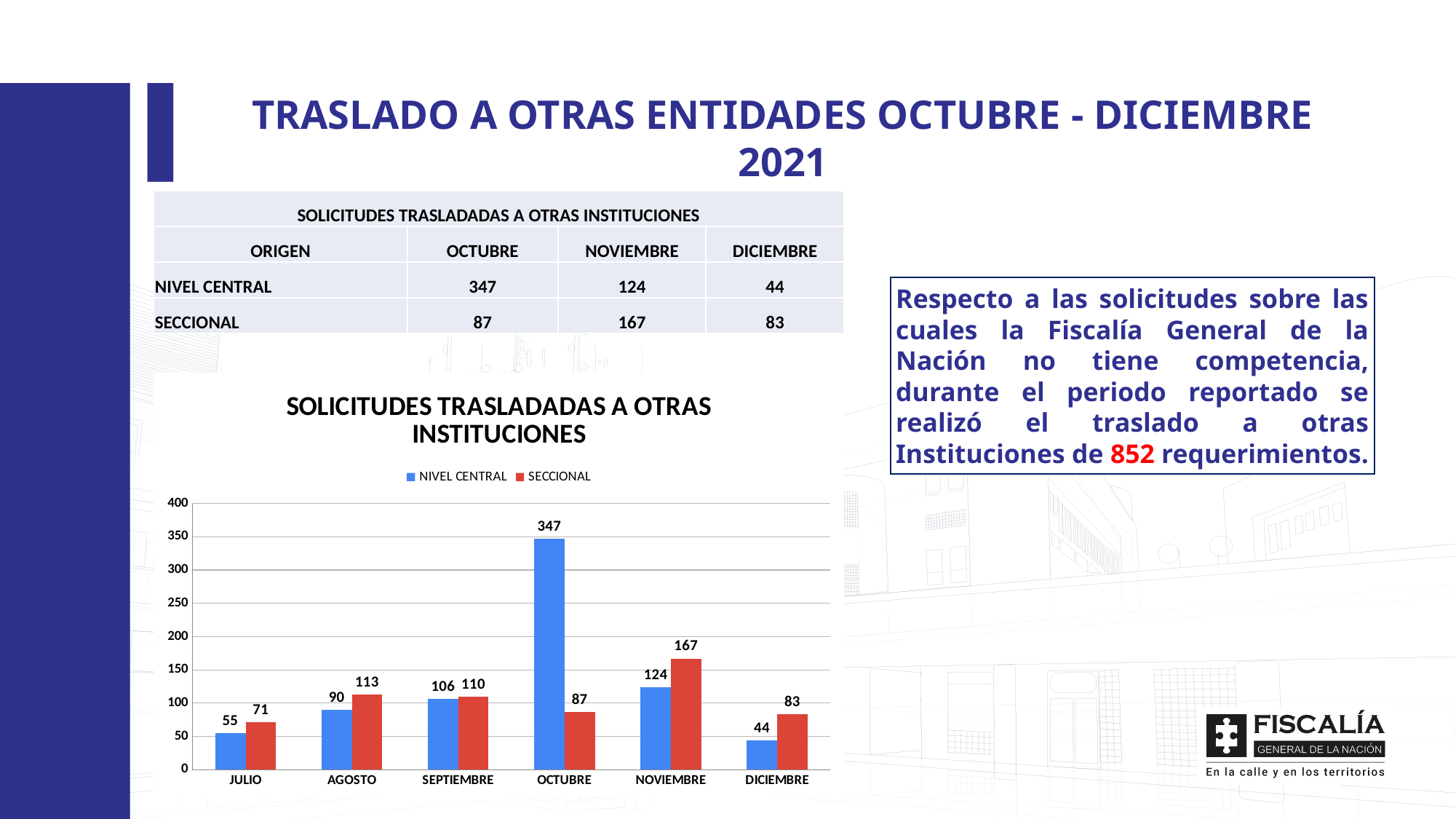
How many series does the chart legend list? 2 Which month has the lowest NIVEL CENTRAL value in the chart? DICIEMBRE What is the SECCIONAL value for NOVIEMBRE in the chart? 167 Which month has the highest NIVEL CENTRAL value in the chart? OCTUBRE Which is larger for NOVIEMBRE, NIVEL CENTRAL or SECCIONAL? SECCIONAL Which month has the lowest SECCIONAL value in the chart? JULIO How many months are shown on the x axis of the chart? 6 What is the NIVEL CENTRAL value for OCTUBRE in the chart? 347 What colour represents the SECCIONAL series in the chart? Red What type of chart is shown on the slide? Bar chart What is the NIVEL CENTRAL value for JULIO in the chart? 55 What is the difference between the NIVEL CENTRAL and SECCIONAL values for OCTUBRE? 260